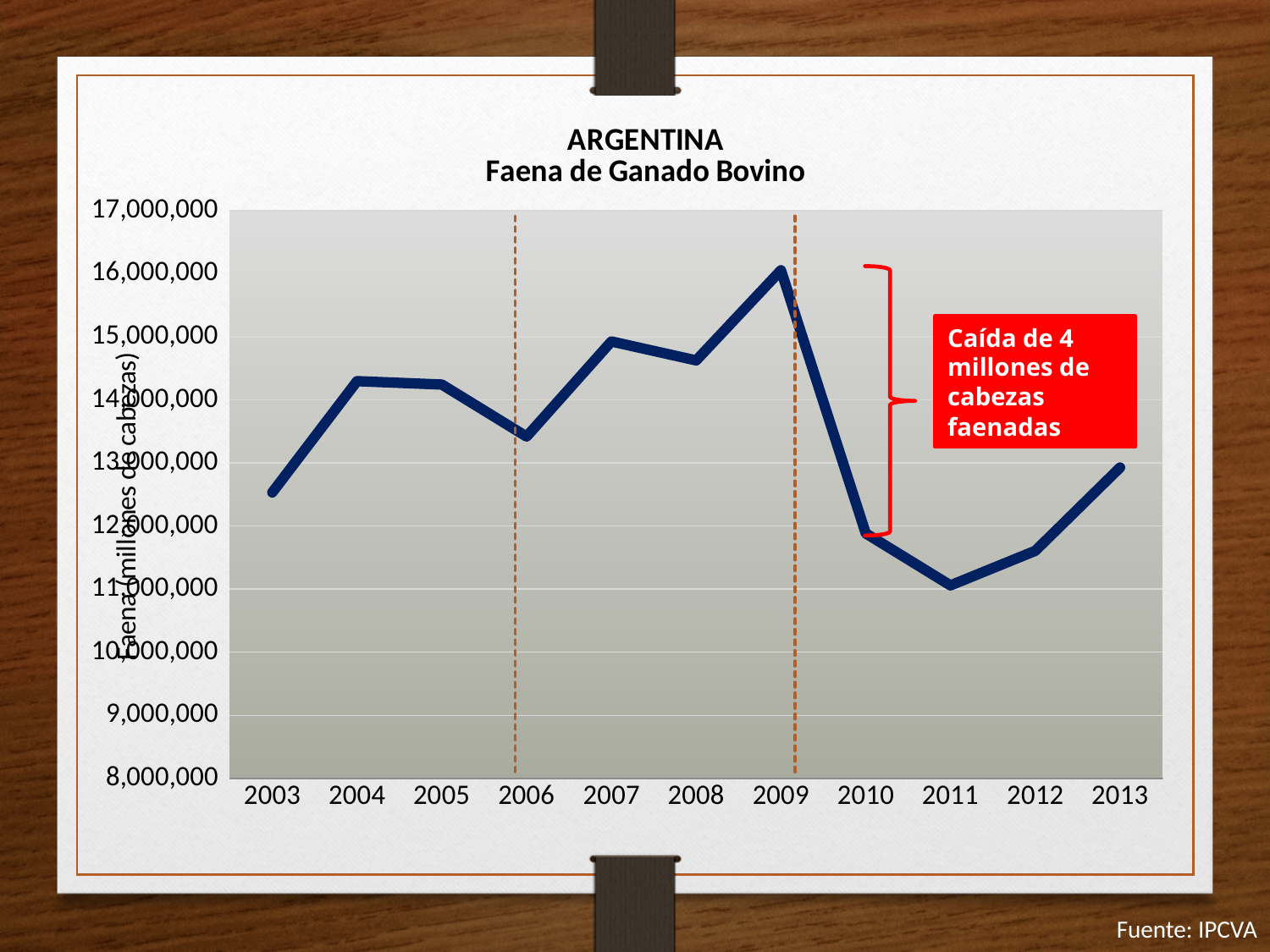
What is the title of the chart? ARGENTINA Faena de Ganado Bovino Is the value for 2009 greater or less than 15,000,000? greater Which year has the larger value, 2009 or 2010? 2009 Is the value for 2011 greater or less than 12,000,000? less Which year has the highest value in the chart? 2009 Do the values rise or fall from 2009 to 2011? fall How many years are plotted along the x axis of the chart? 11 Which year has the lowest value in the chart? 2011 Is the value for 2003 greater or less than 13,000,000? less What does the red annotation box on the chart say? Caída de 4 millones de cabezas faenadas What kind of chart is shown on the slide? line chart